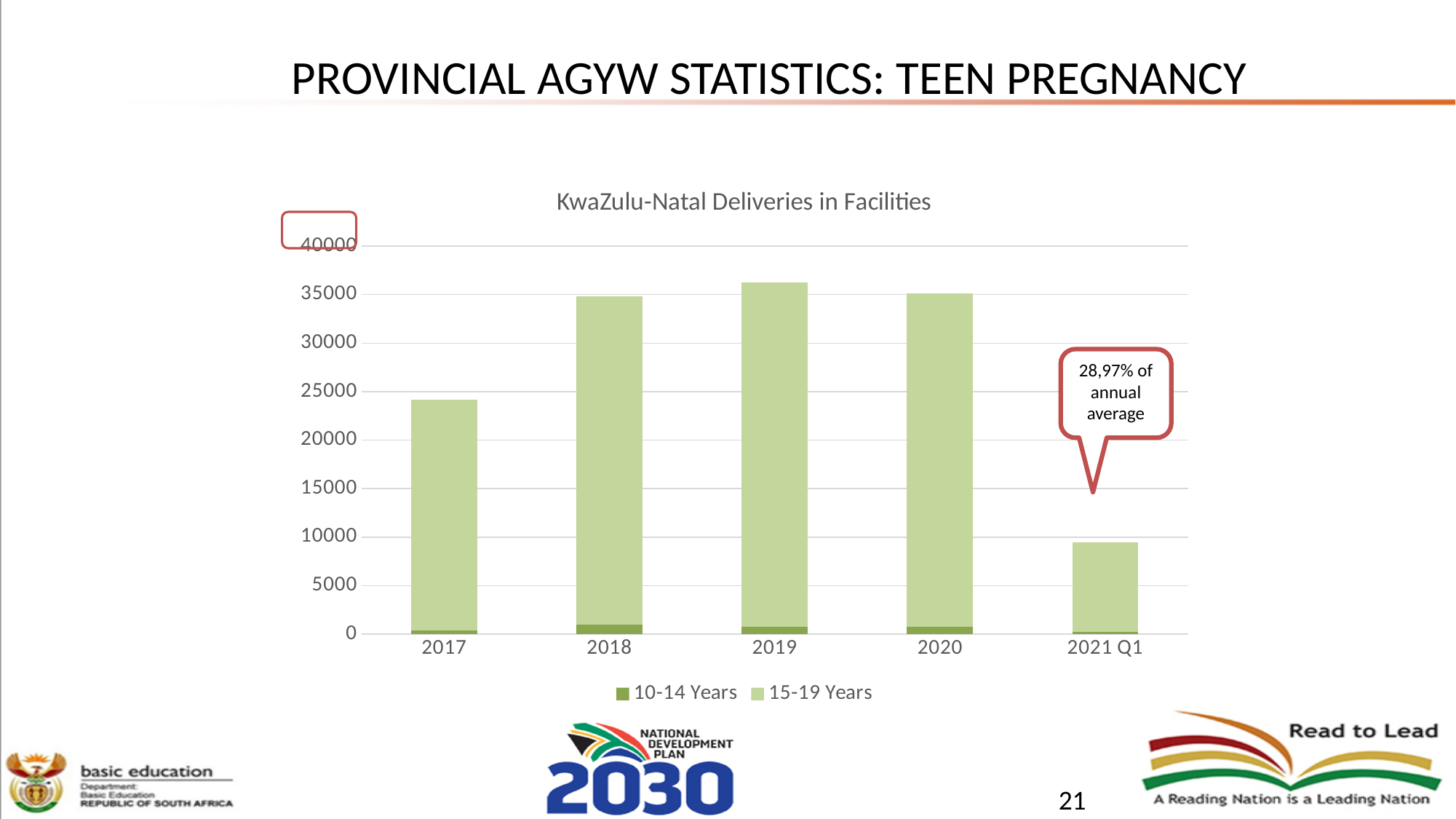
How many categories are shown on the x axis? 5 Is the total value for 2021 Q1 greater or less than 10000? less How many series does the legend list? 2 Which category has the lowest total deliveries in facilities? 2021 Q1 Which year has the highest total deliveries in facilities? 2019 What is the title of the chart? KwaZulu-Natal Deliveries in Facilities What kind of chart is shown on the slide? bar chart Do the total deliveries rise or fall from 2017 to 2019? rise Is the total value for 2017 greater or less than 20000? greater Which is larger, the total for 2017 or the total for 2018? 2018 What does the callout next to the 2021 Q1 bar say? 28,97% of annual average Is the total value for 2019 greater or less than 35000? greater